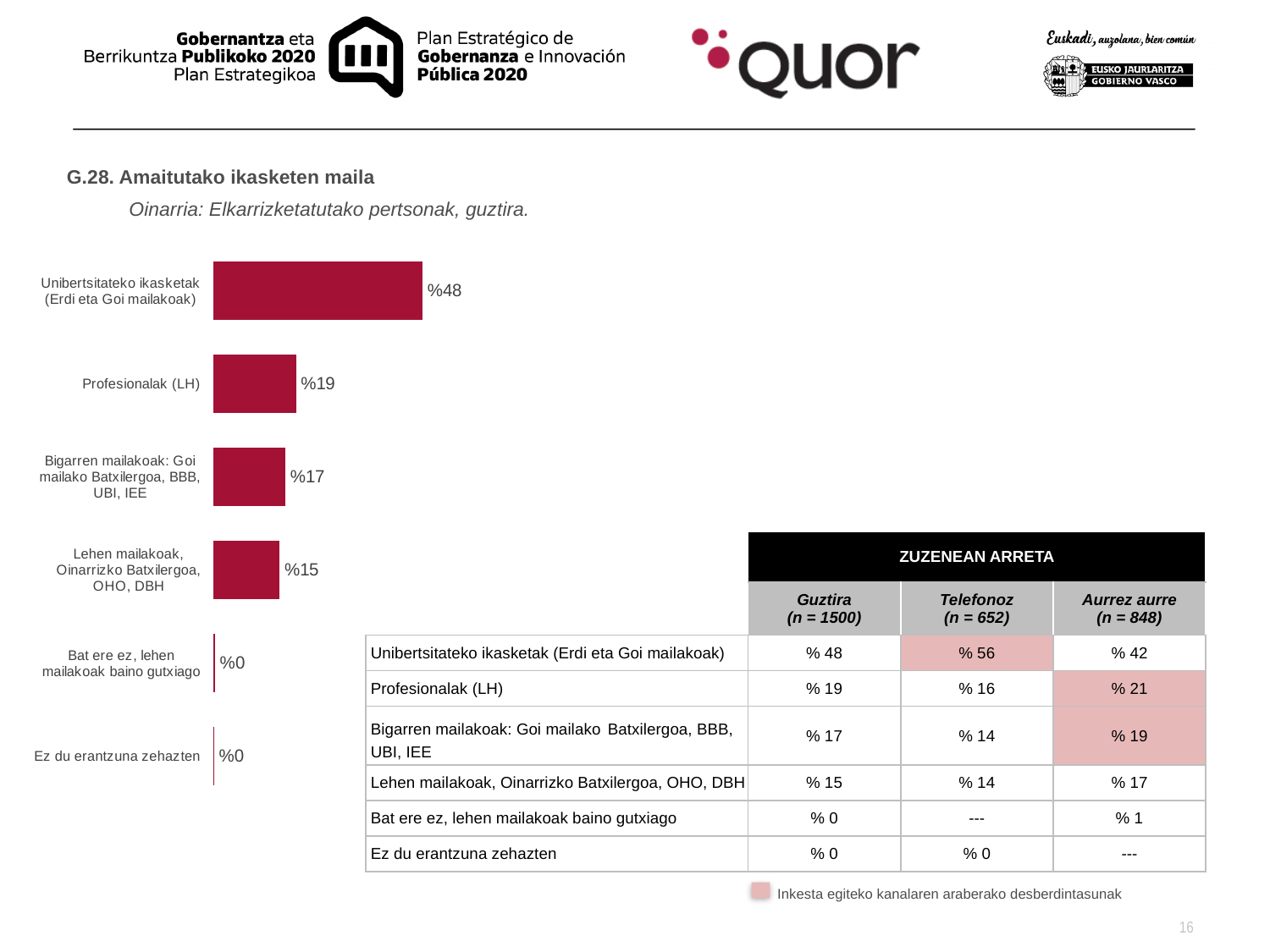
What is the difference between the values for Profesionalak (LH) and Lehen mailakoak, Oinarrizko Batxilergoa, OHO, DBH in the bar chart? %4 What is the value for Unibertsitateko ikasketak (Erdi eta Goi mailakoak) in the bar chart? %48 Which is larger in the bar chart: the value for Profesionalak (LH) or the value for Bigarren mailakoak: Goi mailako Batxilergoa, BBB, UBI, IEE? Profesionalak (LH) How many categories are shown in the bar chart? 6 What is the value for Ez du erantzuna zehazten in the bar chart? %0 What is the value for Bigarren mailakoak: Goi mailako Batxilergoa, BBB, UBI, IEE in the bar chart? %17 What is the difference between the values for Unibertsitateko ikasketak (Erdi eta Goi mailakoak) and Profesionalak (LH) in the bar chart? %29 Which category has the highest value in the bar chart? Unibertsitateko ikasketak (Erdi eta Goi mailakoak) What is the value for Profesionalak (LH) in the bar chart? %19 What kind of chart is shown on the slide? Bar chart What is the value for Lehen mailakoak, Oinarrizko Batxilergoa, OHO, DBH in the bar chart? %15 What is the title of the chart on the slide? G.28. Amaitutako ikasketen maila